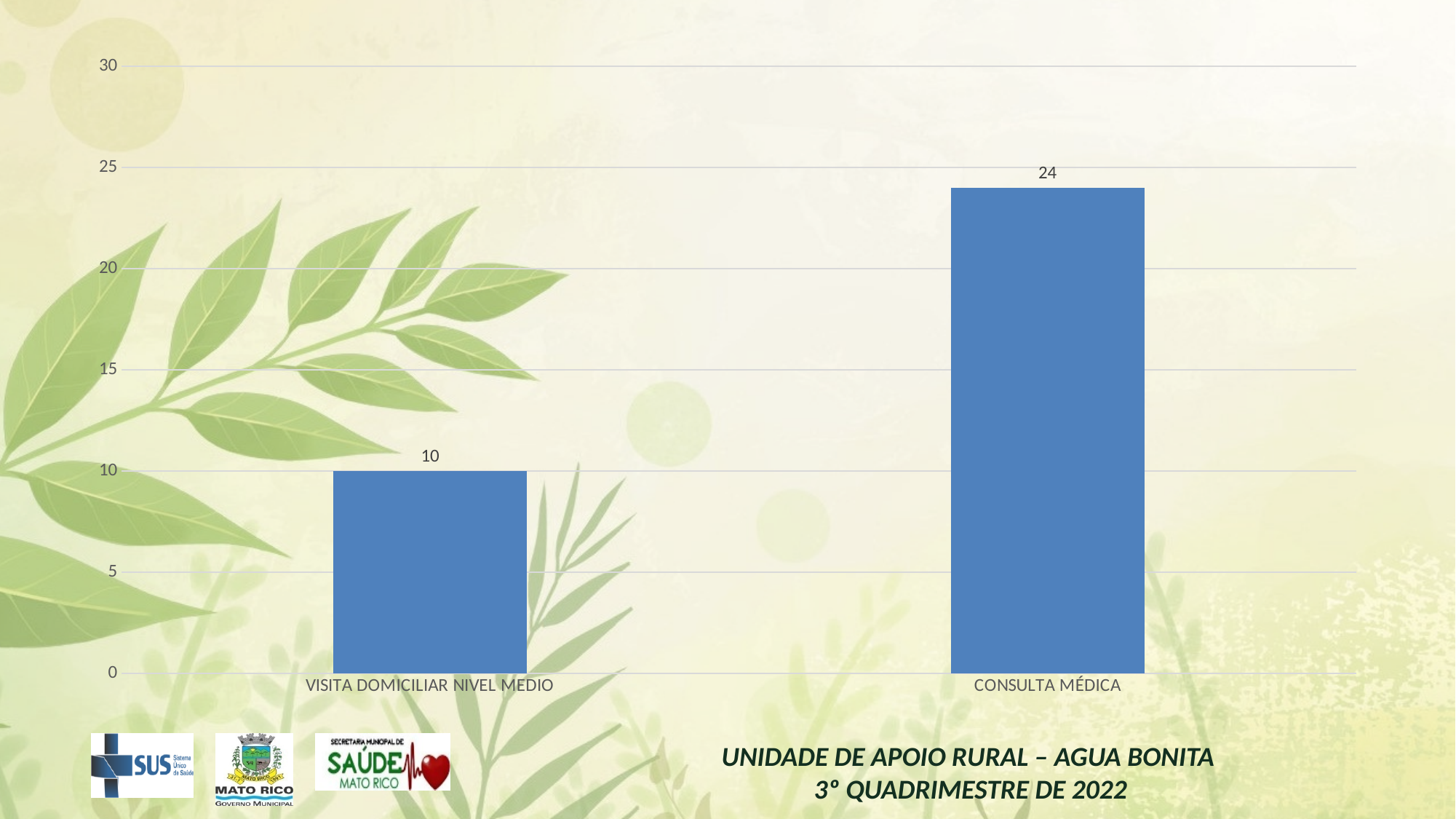
What is the value for CONSULTA MÉDICA? 24 Is the value for CONSULTA MÉDICA greater or less than 20? greater What colour are the bars in the chart? blue What is the value for VISITA DOMICILIAR NIVEL MEDIO? 10 Which category has the lowest value? VISITA DOMICILIAR NIVEL MEDIO How many categories are shown in the chart? 2 What is the highest value shown on the vertical axis? 30 Which is larger, the value for VISITA DOMICILIAR NIVEL MEDIO or the value for CONSULTA MÉDICA? CONSULTA MÉDICA What kind of chart is shown on the slide? bar chart Which category has the highest value? CONSULTA MÉDICA Is the value for VISITA DOMICILIAR NIVEL MEDIO greater or less than 15? less What is the difference between the values for CONSULTA MÉDICA and VISITA DOMICILIAR NIVEL MEDIO? 14